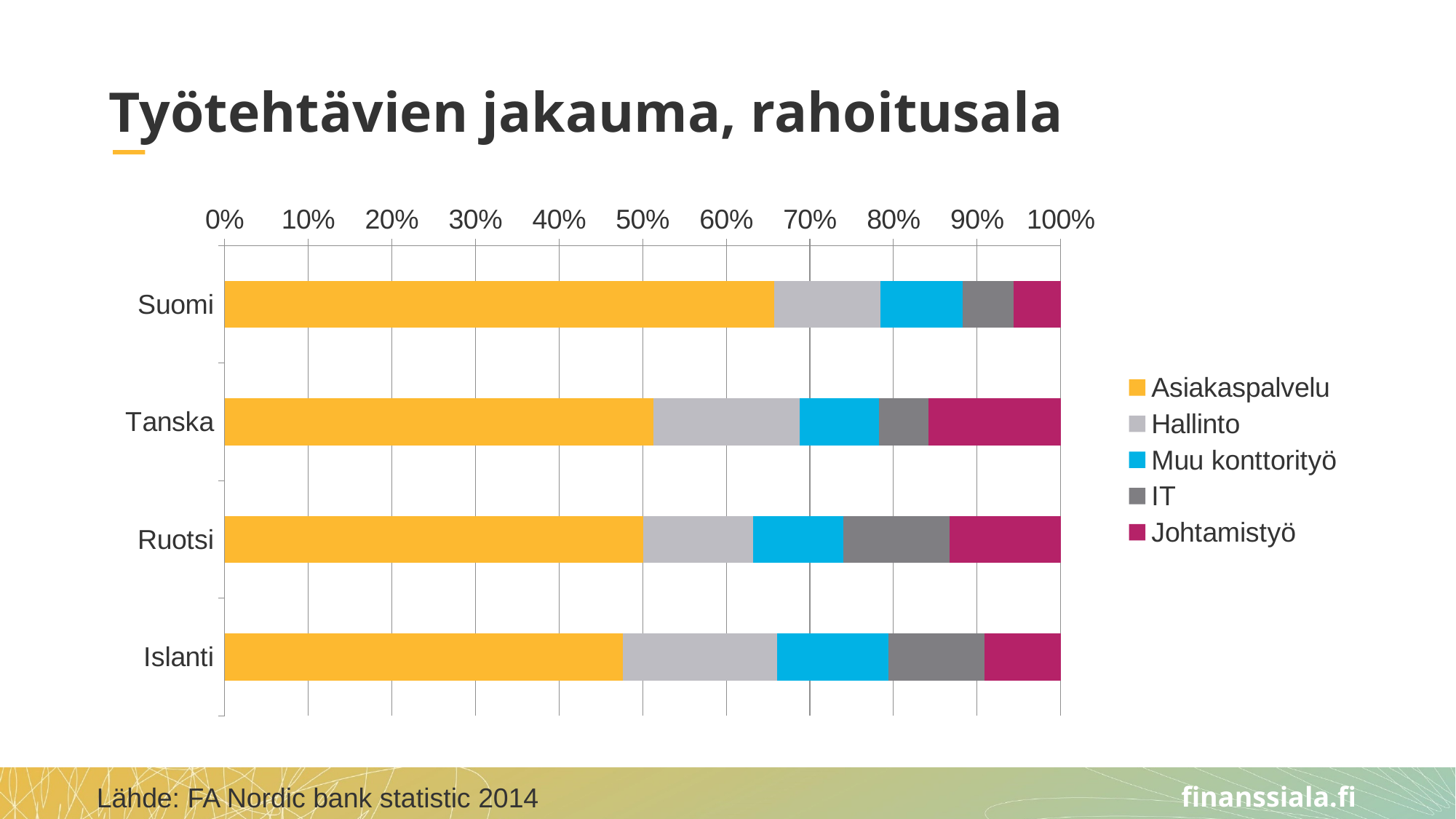
Which country has the largest Johtamistyö share? Tanska Which country has the largest Asiakaspalvelu share? Suomi What is the title of the chart on the slide? Työtehtävien jakauma, rahoitusala Which is larger, the Johtamistyö share for Tanska or for Suomi? Tanska What kind of chart is shown on the slide? Stacked bar chart How many series does the legend list? 5 Is the Asiakaspalvelu share for Suomi greater or less than 60%? greater Is the Asiakaspalvelu share for Islanti greater or less than 60%? less Which is larger, the IT share for Ruotsi or for Tanska? Ruotsi Which country has the smallest Johtamistyö share? Suomi Which series is shown in orange in the legend? Asiakaspalvelu How many countries are shown on the chart? 4